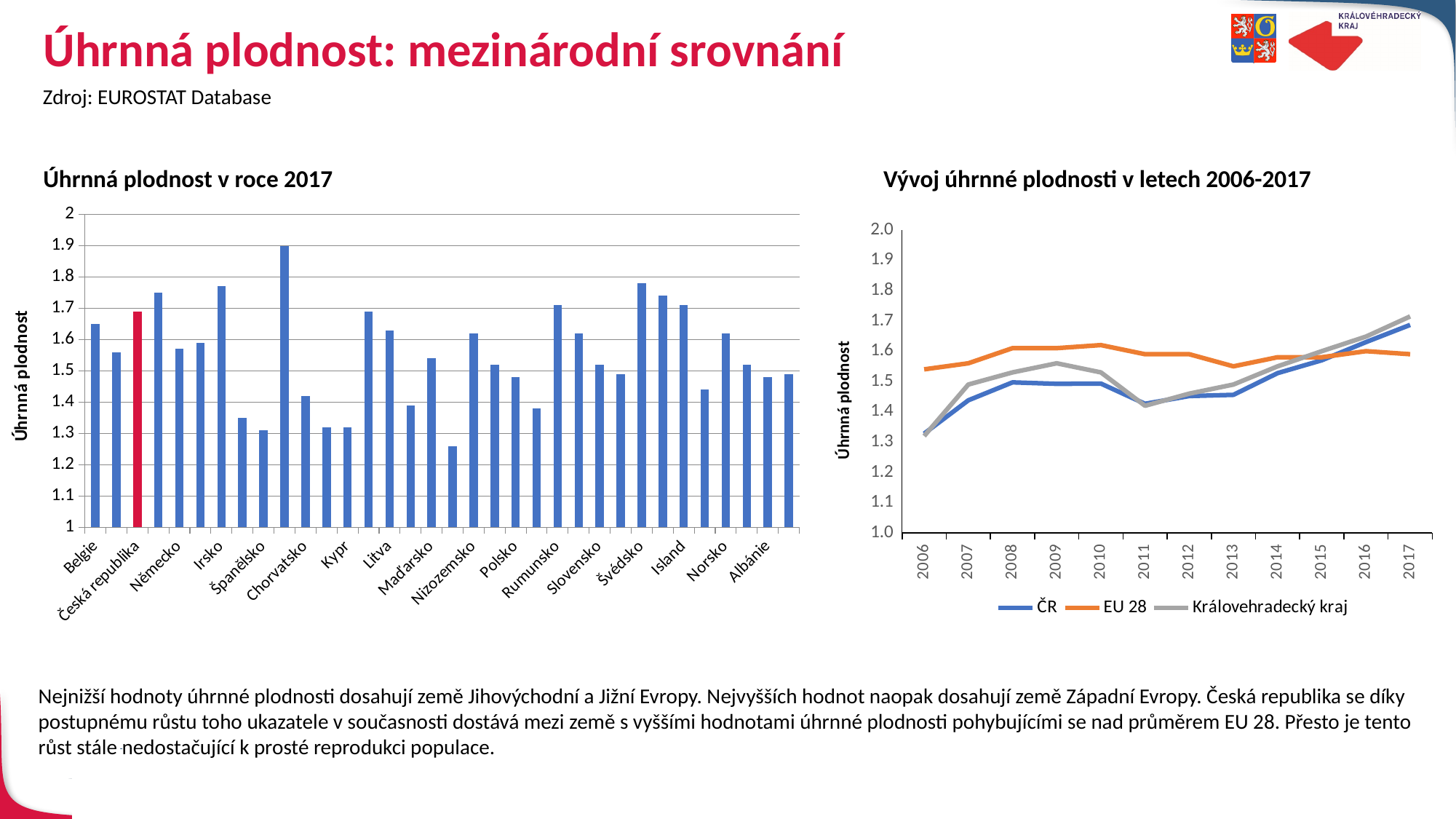
In the left chart "Úhrnná plodnost v roce 2017", is the value for Česká republika greater or less than 1.6? greater What kind of chart is the left chart titled "Úhrnná plodnost v roce 2017"? bar chart In the left chart "Úhrnná plodnost v roce 2017", which has the larger value, Irsko or Španělsko? Irsko How many years are shown on the x axis of the right chart "Vývoj úhrnné plodnosti v letech 2006-2017"? 12 In the left chart "Úhrnná plodnost v roce 2017", which has the larger value, Švédsko or Polsko? Švédsko In the left chart "Úhrnná plodnost v roce 2017", is the value for Španělsko greater or less than 1.4? less What kind of chart is the right chart titled "Vývoj úhrnné plodnosti v letech 2006-2017"? line chart In the left chart "Úhrnná plodnost v roce 2017", is the value for Kypr greater or less than 1.4? less In the left chart "Úhrnná plodnost v roce 2017", what colour is the bar for Česká republika? red In the right chart "Vývoj úhrnné plodnosti v letech 2006-2017", does the ČR line overall rise or fall from 2006 to 2017? rise How many series does the legend of the right chart "Vývoj úhrnné plodnosti v letech 2006-2017" list? 3